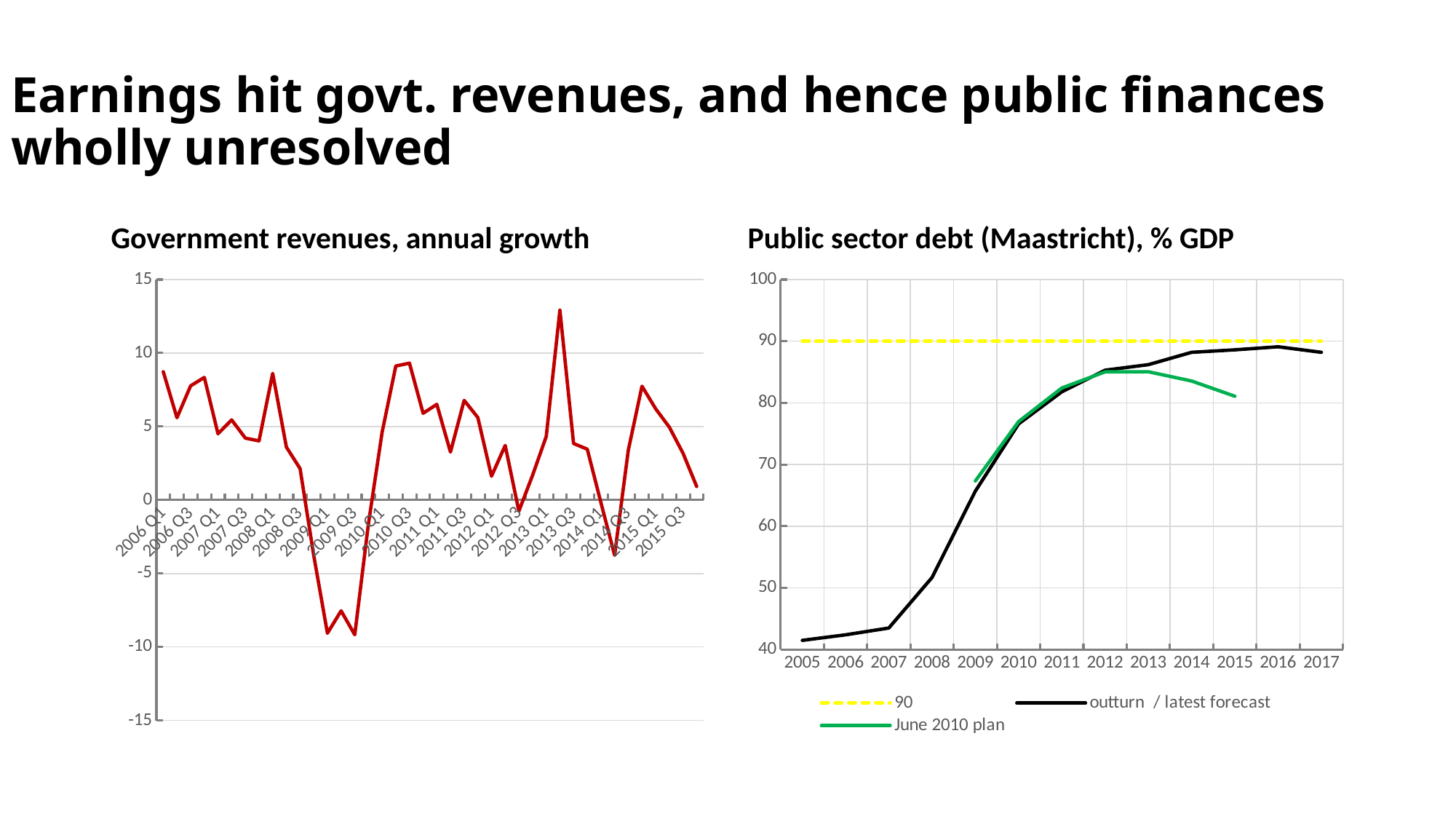
In the 'Public sector debt (Maastricht), % GDP' chart, what colour is the June 2010 plan line? green How many series does the legend of the 'Public sector debt (Maastricht), % GDP' chart list? 3 What kind of chart is the 'Government revenues, annual growth' chart? line chart In the 'Public sector debt (Maastricht), % GDP' chart, which is larger in 2015: the outturn / latest forecast or the June 2010 plan? outturn / latest forecast In the 'Public sector debt (Maastricht), % GDP' chart, is the outturn / latest forecast value for 2005 greater or less than 50? less What kind of chart is the 'Public sector debt (Maastricht), % GDP' chart? line chart In the 'Public sector debt (Maastricht), % GDP' chart, does the outturn / latest forecast line rise or fall from 2005 to 2016? rise In the 'Government revenues, annual growth' chart, is the value for 2013 Q3 greater or less than 10? less In the 'Public sector debt (Maastricht), % GDP' chart, is the outturn / latest forecast value for 2017 greater or less than 90? less In the 'Government revenues, annual growth' chart, which quarter has the highest value? 2013 Q2